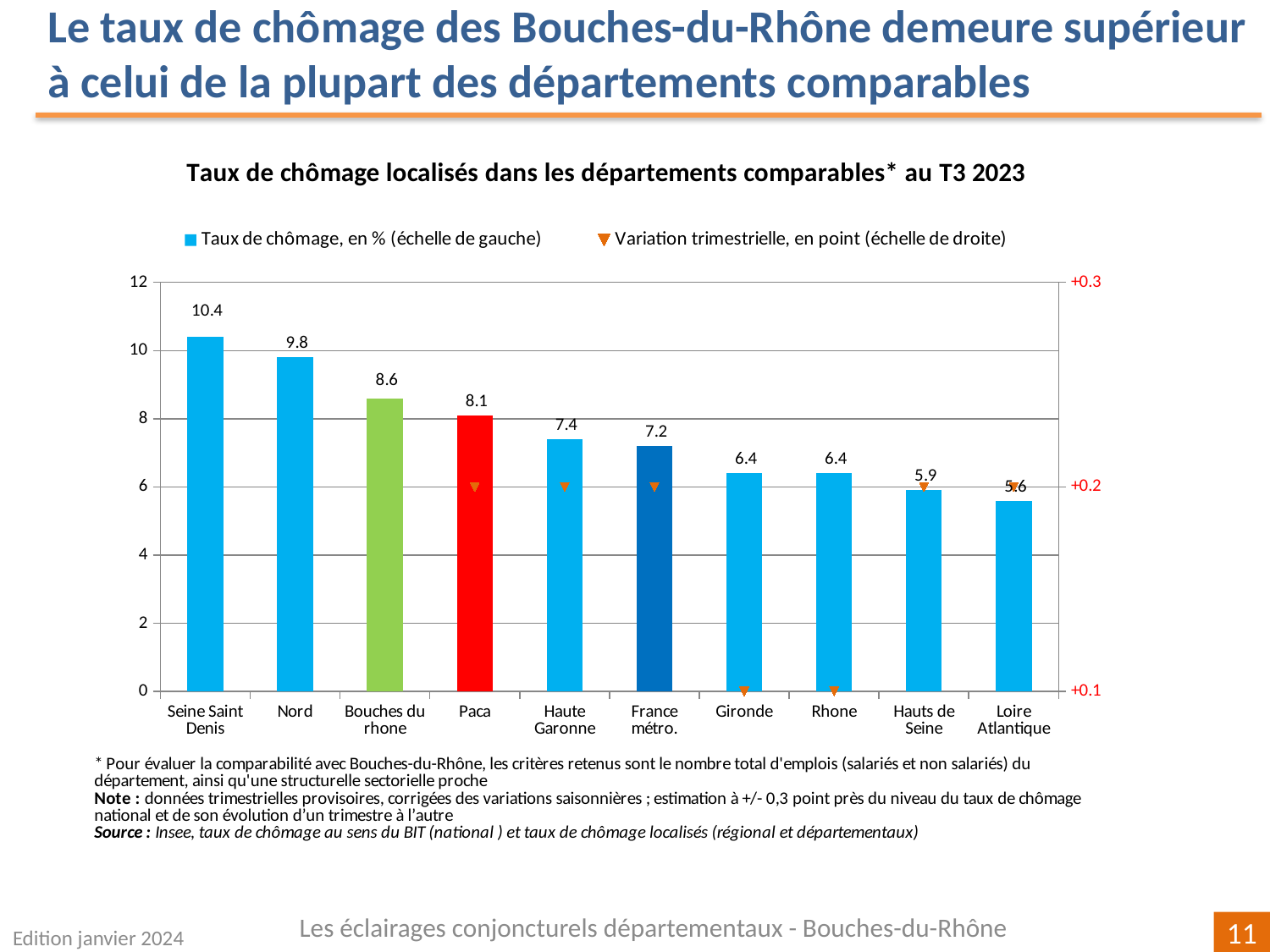
Which category has the lowest unemployment rate? Loire Atlantique What colour is the bar for Paca? Red What kind of chart is this? Bar chart Which has a higher unemployment rate, Nord or Haute Garonne? Nord What is the unemployment rate shown for Bouches du rhone? 8.6 What is the unemployment rate shown for France métro.? 7.2 What is the unemployment rate shown for Seine Saint Denis? 10.4 What is the quarterly variation (right axis) shown for Gironde? +0.1 How many categories are shown on the x axis? 10 Which category has the highest unemployment rate? Seine Saint Denis What is the difference between the unemployment rates of Bouches du rhone and Paca? 0.5 How many series does the legend list? 2